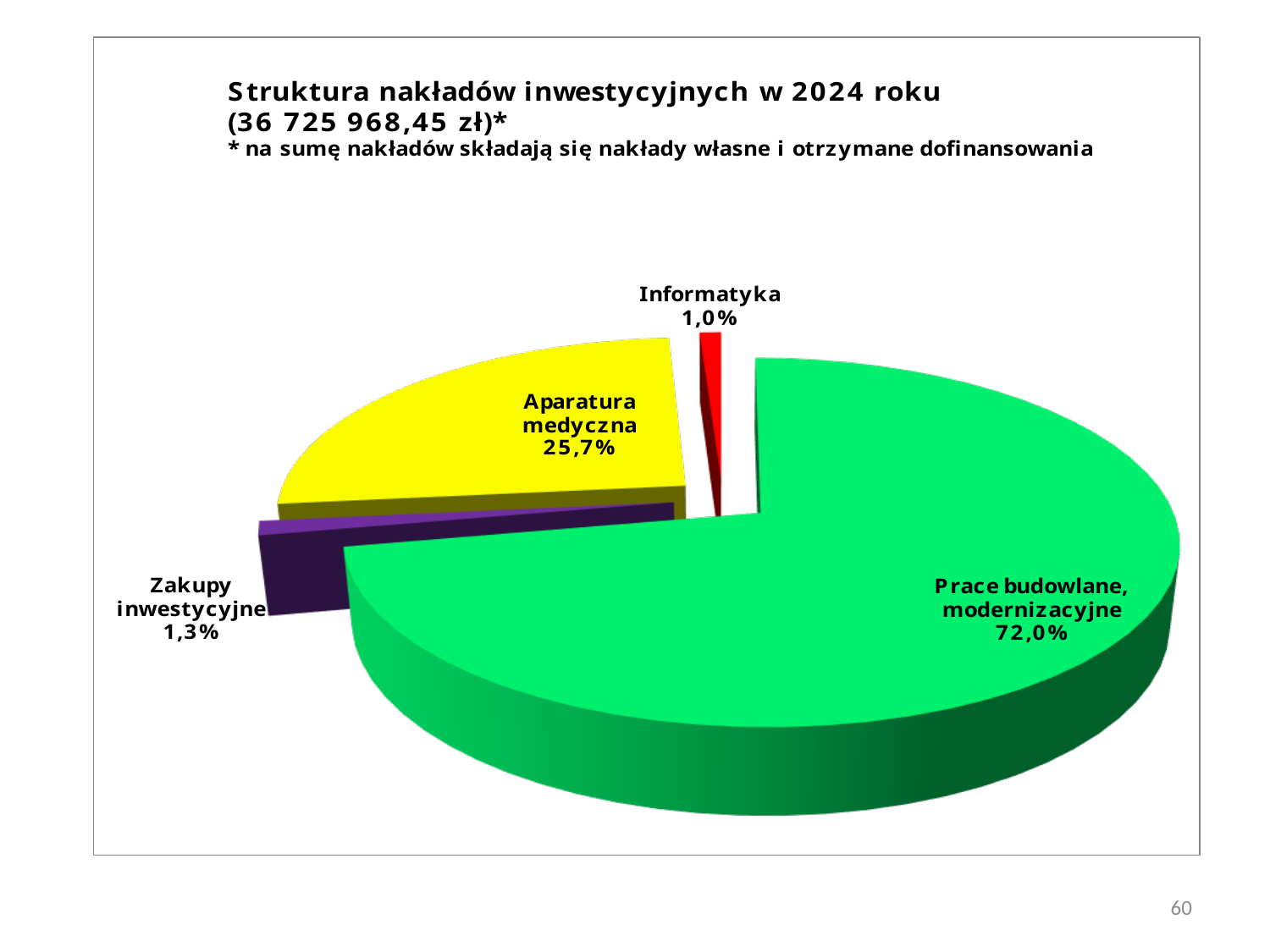
What colour is the slice for "Aparatura medyczna"? Yellow Which is larger: the share for "Zakupy inwestycyjne" or the share for "Informatyka"? Zakupy inwestycyjne How many categories (slices) does the pie chart have? 4 What is the difference in percentage points between "Prace budowlane, modernizacyjne" and "Aparatura medyczna"? 46,3 Which category has the largest share of the pie? Prace budowlane, modernizacyjne What is the value shown for "Informatyka"? 1,0% Which category has the smallest share of the pie? Informatyka What is the value shown for "Zakupy inwestycyjne"? 1,3% What total amount of investment outlays is given in the chart title? 36 725 968,45 zł What type of chart is shown on the slide? Pie chart What share of the pie does "Aparatura medyczna" represent? 25,7% What share of the pie does "Prace budowlane, modernizacyjne" represent? 72,0%